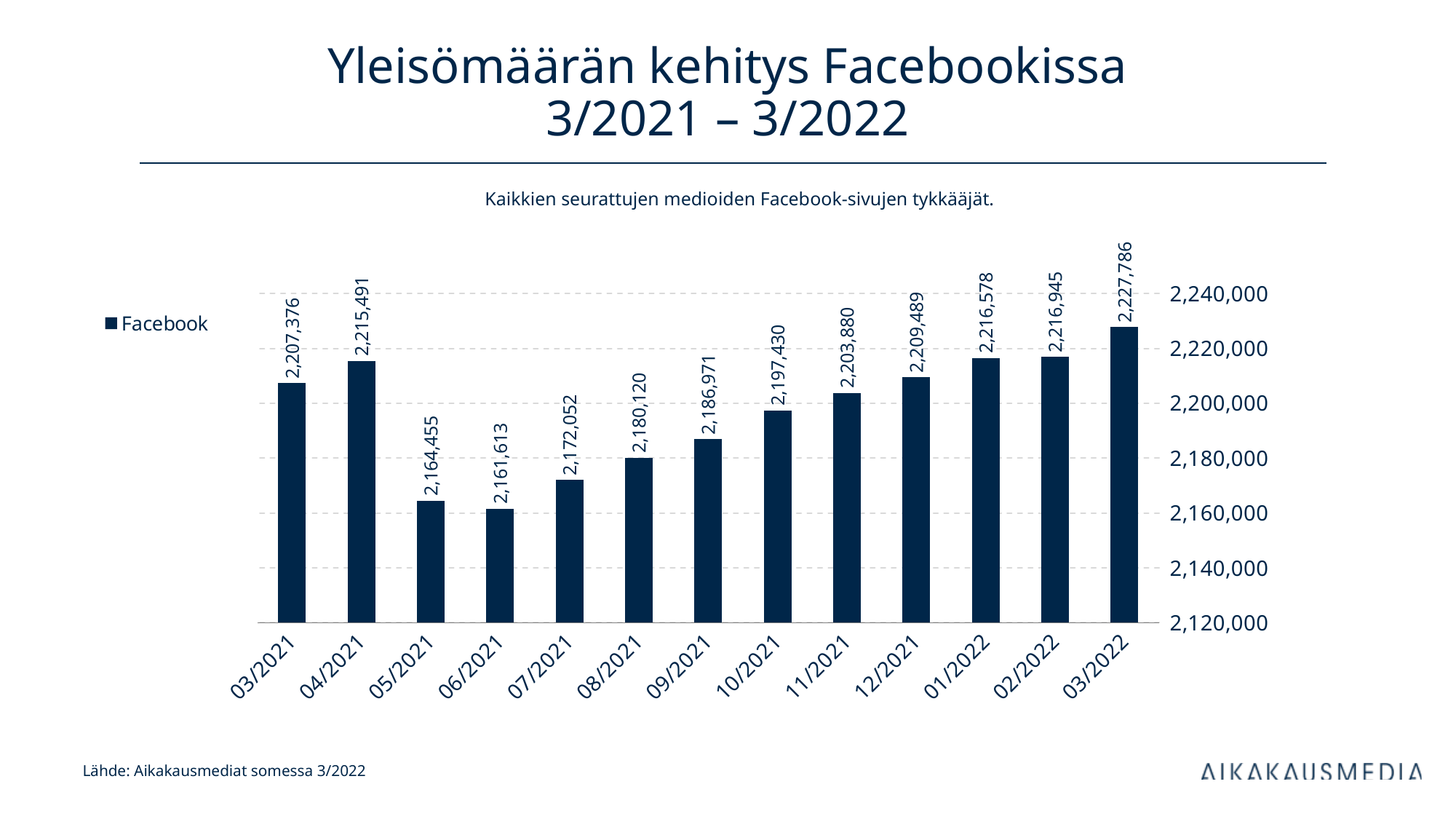
Which month has the lowest value? 06/2021 What series name does the legend show? Facebook What kind of chart is shown on the slide? bar chart Which is larger, the value for 04/2021 or the value for 12/2021? 04/2021 What is the difference between the values for 03/2022 and 03/2021? 20,410 What is the value for 03/2021? 2,207,376 How many months are shown on the x axis? 13 Is the value for 08/2021 greater or less than 2,200,000? less What is the value for 06/2021? 2,161,613 What is the difference between the values for 04/2021 and 05/2021? 51,036 What is the value for 03/2022? 2,227,786 Which month has the highest value? 03/2022